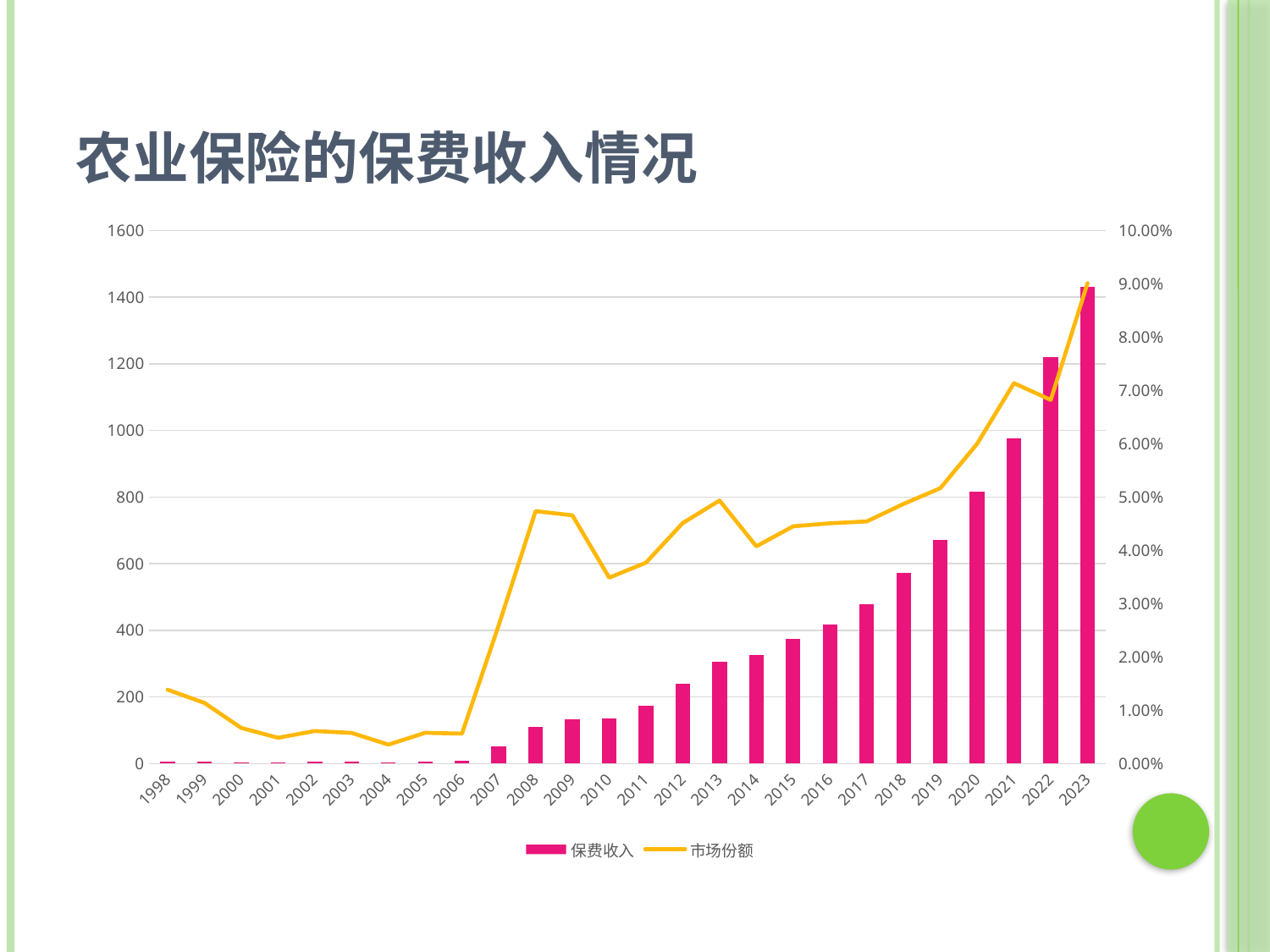
Is the 保费收入 value for 2011 greater or less than 200? less How many series does the legend list? 2 Is the 市场份额 value for 2004 greater or less than 1.00%? less Which year has the highest 保费收入 bar? 2023 Is the 保费收入 value for 2021 greater or less than 1000? less What kind of chart is shown on the slide? A combination bar and line chart Which year has the highest 市场份额 value? 2023 Which is larger, the 市场份额 value for 2008 or for 2010? 2008 Do the 保费收入 bars generally rise or fall from 1998 to 2023? rise How many years are shown on the x axis? 26